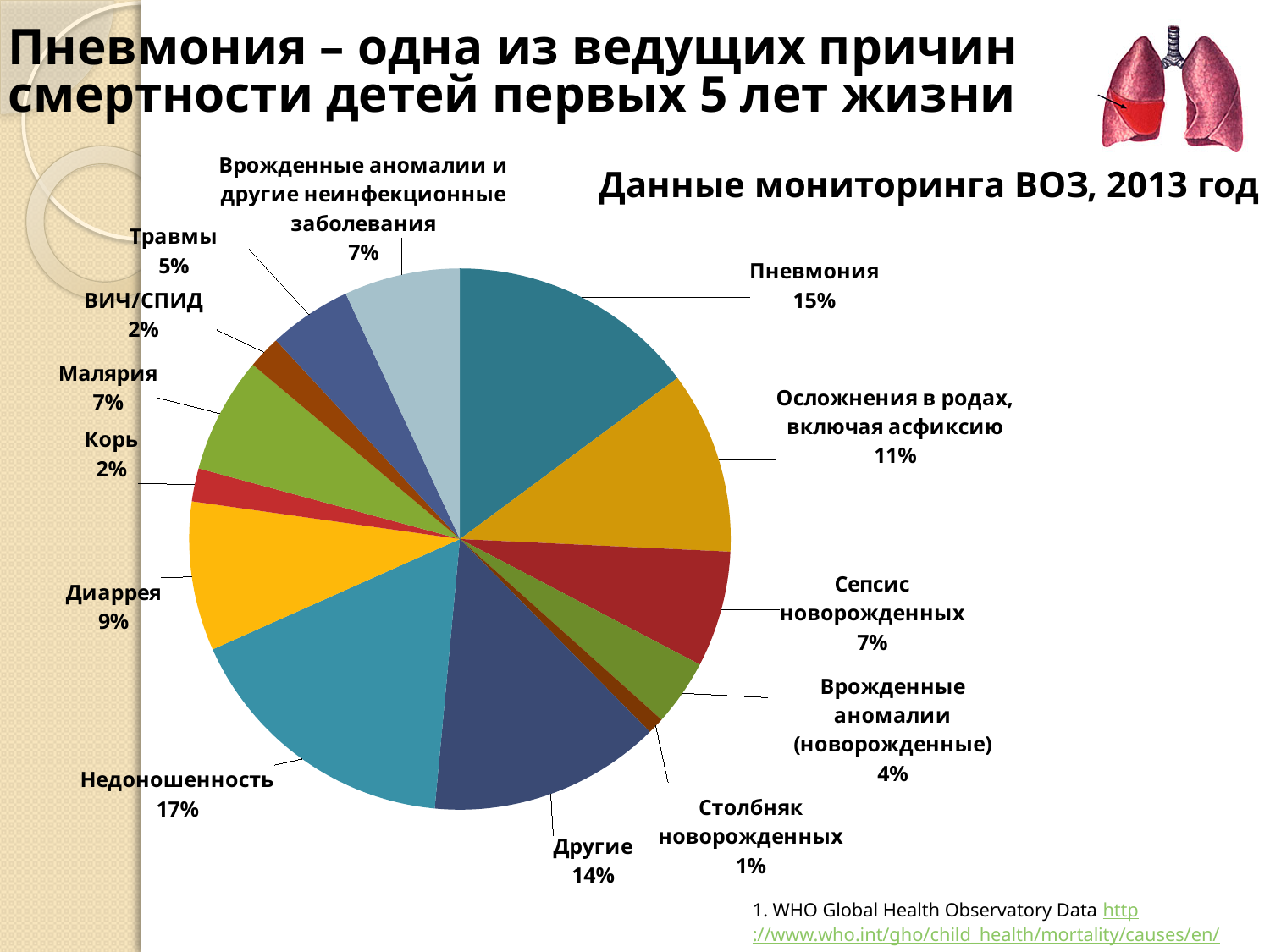
What kind of chart is shown on the slide? pie chart What is the title shown above the pie chart? Данные мониторинга ВОЗ, 2013 год What is the value for Осложнения в родах, включая асфиксию? 11% Which category has the largest slice of the pie? Недоношенность What share of the pie does Пневмония account for? 15% What is the difference between the values for Пневмония and Другие? 1% Which category has the smallest slice of the pie? Столбняк новорожденных How many categories are shown in the pie chart? 13 What percentage is shown for Диаррея? 9% Which is larger, the slice for Малярия or the slice for Травмы? Малярия What is the value shown for Недоношенность? 17% What is the difference between the values for Недоношенность and Диаррея? 8%